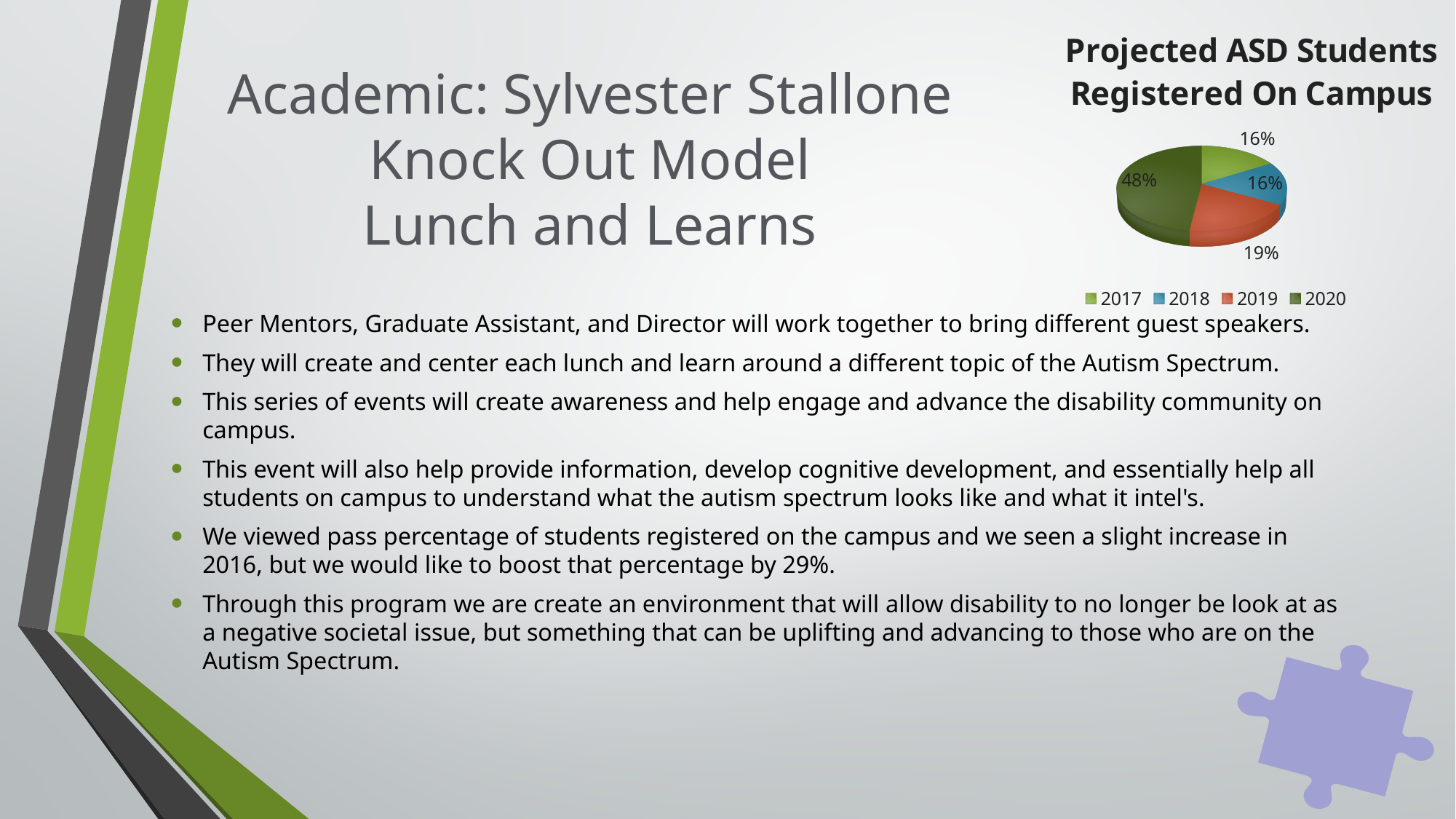
What type of chart is shown on the slide? Pie chart What percentage of the pie is for 2020? 48% What percentage of the pie is for 2019? 19% What is the title of the chart? Projected ASD Students Registered On Campus What is the difference between the 2020 and 2019 slices? 29% How many entries does the legend list? 4 What percentage of the pie is for 2017? 16% How many years are shown in the pie chart? 4 Which year has the largest slice of the pie? 2020 What colour is the slice for 2018? Blue Which slice is larger, 2019 or 2018? 2019 What percentage of the pie is for 2018? 16%